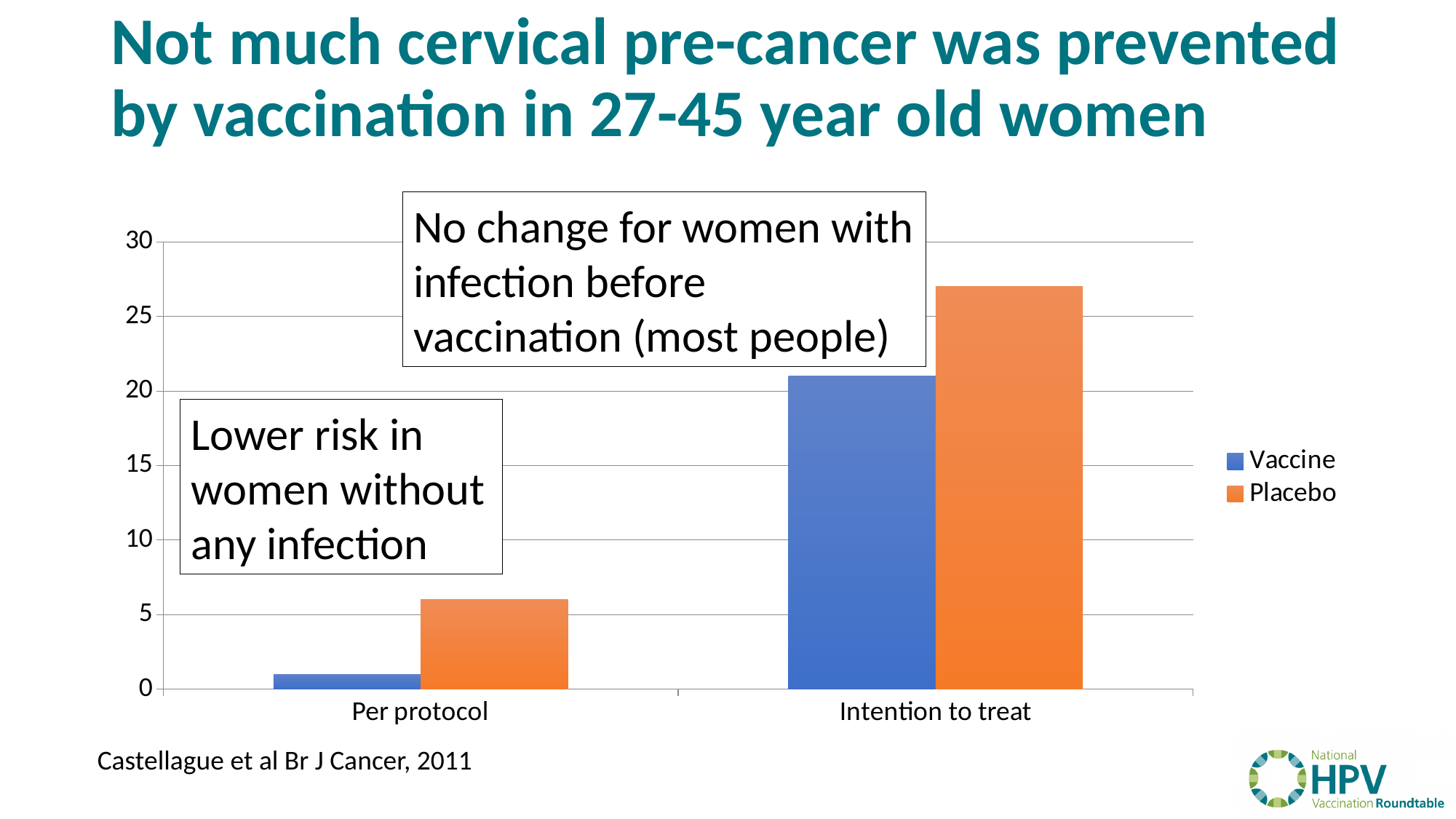
Is the Vaccine value for Intention to treat greater or less than 15? greater What colour are the Placebo bars? orange How many series does the legend list? 2 Which series has the lower value for Per protocol, Vaccine or Placebo? Vaccine What kind of chart is shown on the slide? bar chart Is the Placebo value for Per protocol greater or less than 10? less Is the Vaccine value for Per protocol greater or less than 5? less How many categories are shown on the x axis? 2 Which bar is the tallest in the chart? Placebo, Intention to treat Which bar is the shortest in the chart? Vaccine, Per protocol Which series has the higher value for Intention to treat, Vaccine or Placebo? Placebo